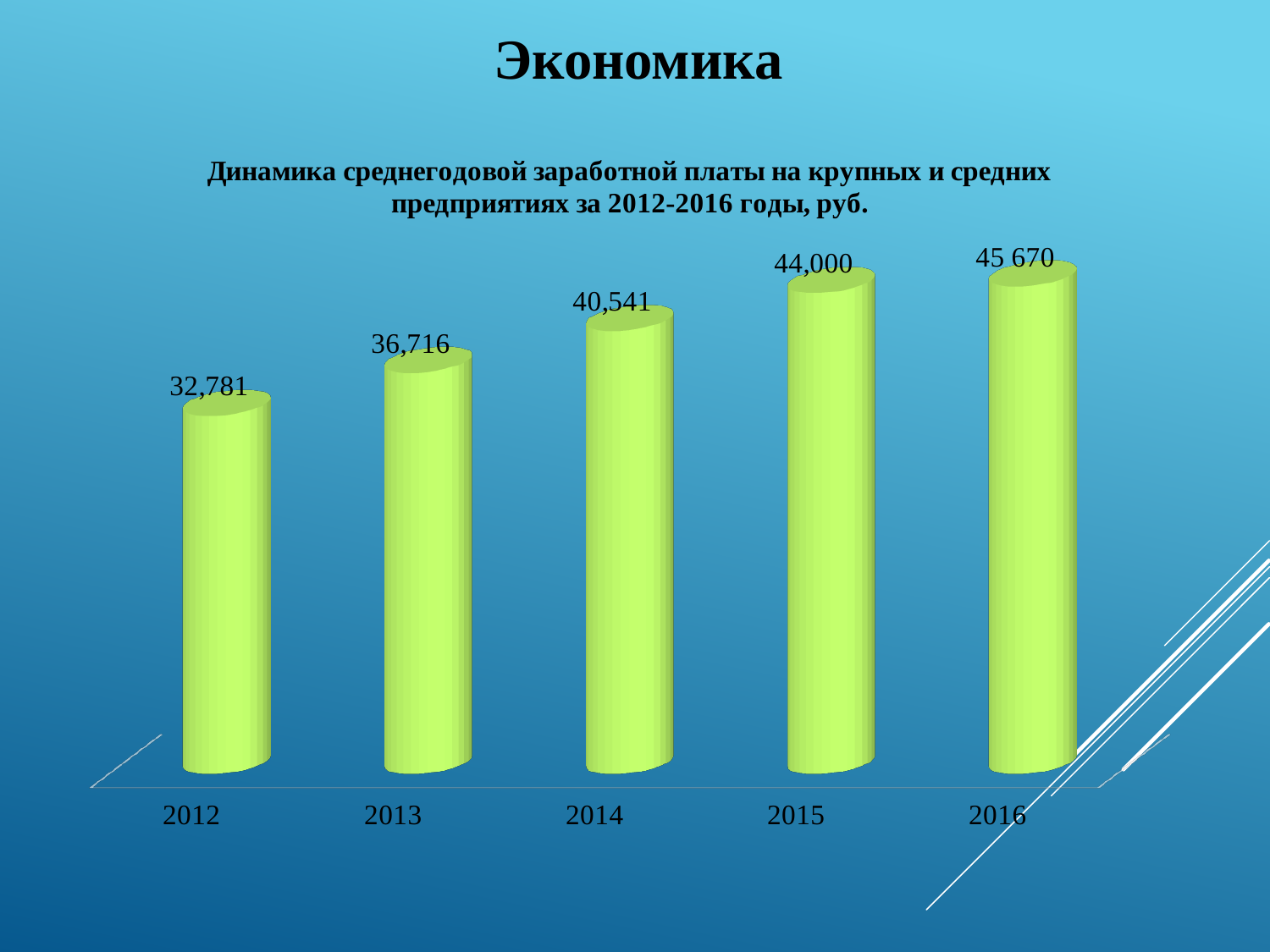
What kind of chart is shown on the slide? Bar chart What is the value for 2012? 32,781 What is the difference between the values for 2013 and 2012? 3,935 Do the values rise or fall from 2012 to 2016? Rise What is the value for 2016? 45 670 How many years are shown on the chart? 5 Which year has the lowest value? 2012 Which is larger, the value for 2013 or the value for 2015? 2015 What is the title of the chart? Динамика среднегодовой заработной платы на крупных и средних предприятиях за 2012-2016 годы, руб. Which year has the highest value? 2016 What is the difference between the values for 2015 and 2014? 3,459 What is the value for 2014? 40,541